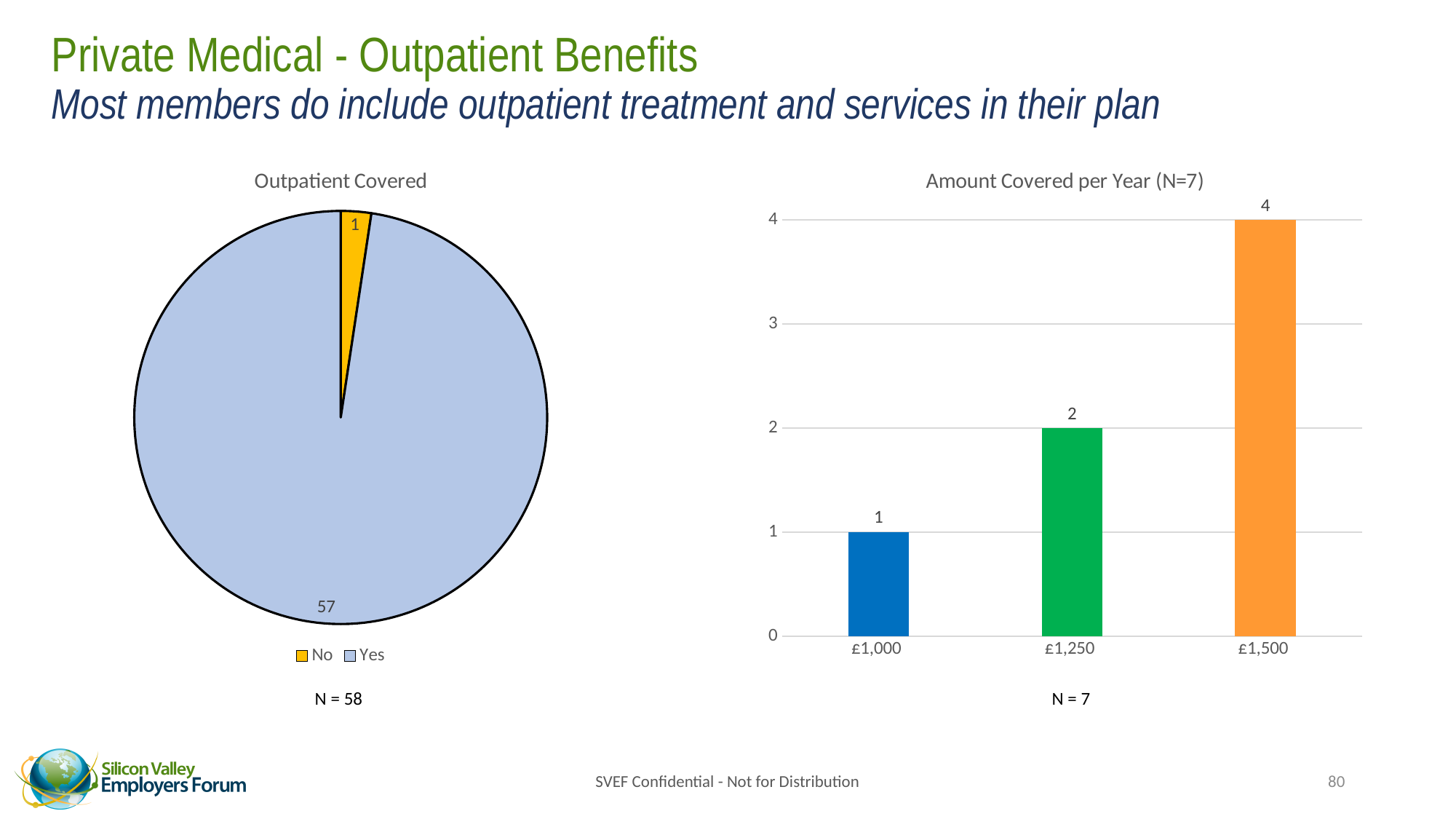
What kind of chart is 'Amount Covered per Year (N=7)'? Bar chart In the 'Amount Covered per Year (N=7)' chart, what is the value for £1,250? 2 What kind of chart is 'Outpatient Covered'? Pie chart In the 'Amount Covered per Year (N=7)' chart, which category has the lowest value? £1,000 In the 'Amount Covered per Year (N=7)' chart, what is the value for £1,500? 4 In the 'Outpatient Covered' pie chart, how many slices are there? 2 In the 'Amount Covered per Year (N=7)' chart, do the values rise or fall from £1,000 to £1,500? Rise In the 'Amount Covered per Year (N=7)' chart, what is the difference between the values for £1,500 and £1,000? 3 In the 'Outpatient Covered' pie chart, what colour is the 'No' slice? Yellow In the 'Outpatient Covered' pie chart, which slice is the largest? Yes In the 'Outpatient Covered' pie chart, what is the value for 'Yes'? 57 In the 'Outpatient Covered' pie chart, what is the value for 'No'? 1